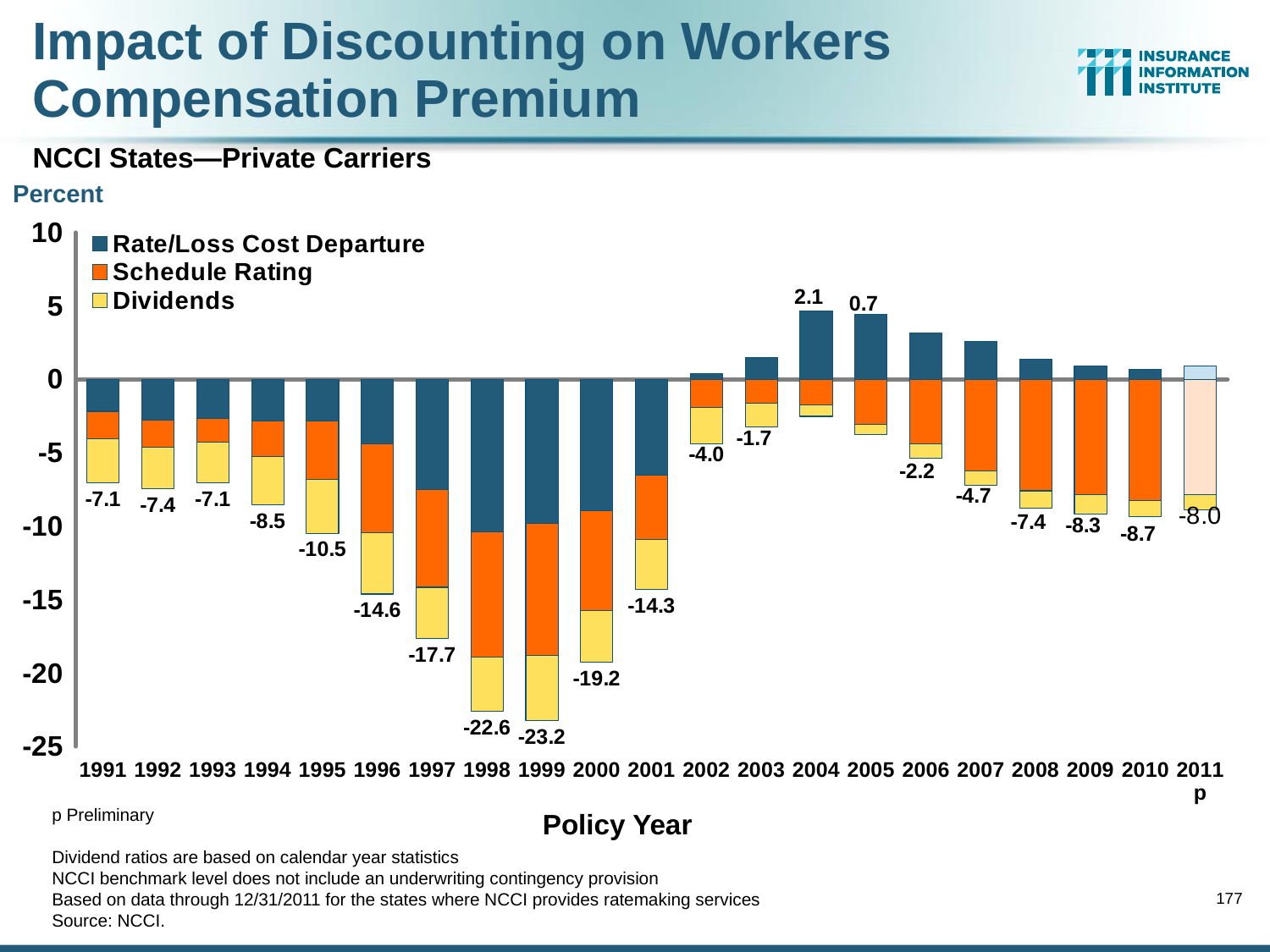
What is the labeled total value for policy year 2004? 2.1 What kind of chart is shown on the slide? Stacked bar chart What is the labeled total value for policy year 2011p? -8.0 Is the Rate/Loss Cost Departure value for 2004 greater or less than 0? greater Which policy year has the lowest (most negative) labeled total? 1999 How many series does the legend list? 3 What is the difference between the labeled totals for 1998 and 1999? 0.6 Which series is shown in yellow in the legend? Dividends What is the labeled total value for policy year 1999? -23.2 Which policy year has the highest labeled total? 2004 Which policy year has a larger labeled total, 2005 or 2006? 2005 How many policy years are shown on the x axis? 21